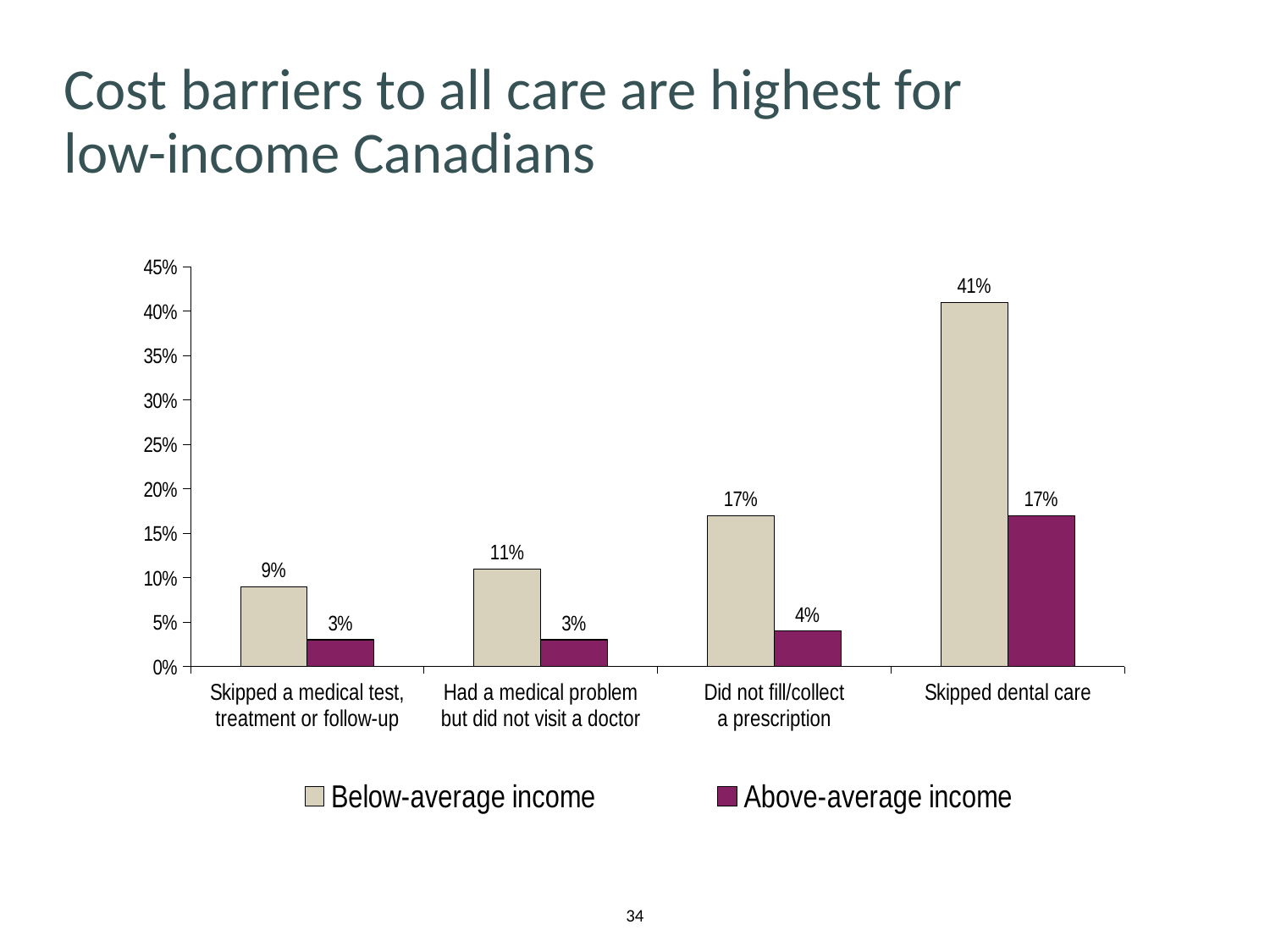
What is the difference between Below-average income and Above-average income for Skipped a medical test, treatment or follow-up? 6% How many series does the legend list? 2 What is the value for Below-average income for Skipped dental care? 41% Which category has the highest value for Below-average income? Skipped dental care What is the value for Below-average income for Had a medical problem but did not visit a doctor? 11% What kind of chart is shown on the slide? Bar chart What is the value for Above-average income for Did not fill/collect a prescription? 4% What is the title of the slide? Cost barriers to all care are highest for low-income Canadians What is the difference between Below-average income and Above-average income for Skipped dental care? 24% Which is larger for Did not fill/collect a prescription: Below-average income or Above-average income? Below-average income Which category has the lowest value for Below-average income? Skipped a medical test, treatment or follow-up How many categories are shown on the x axis? 4